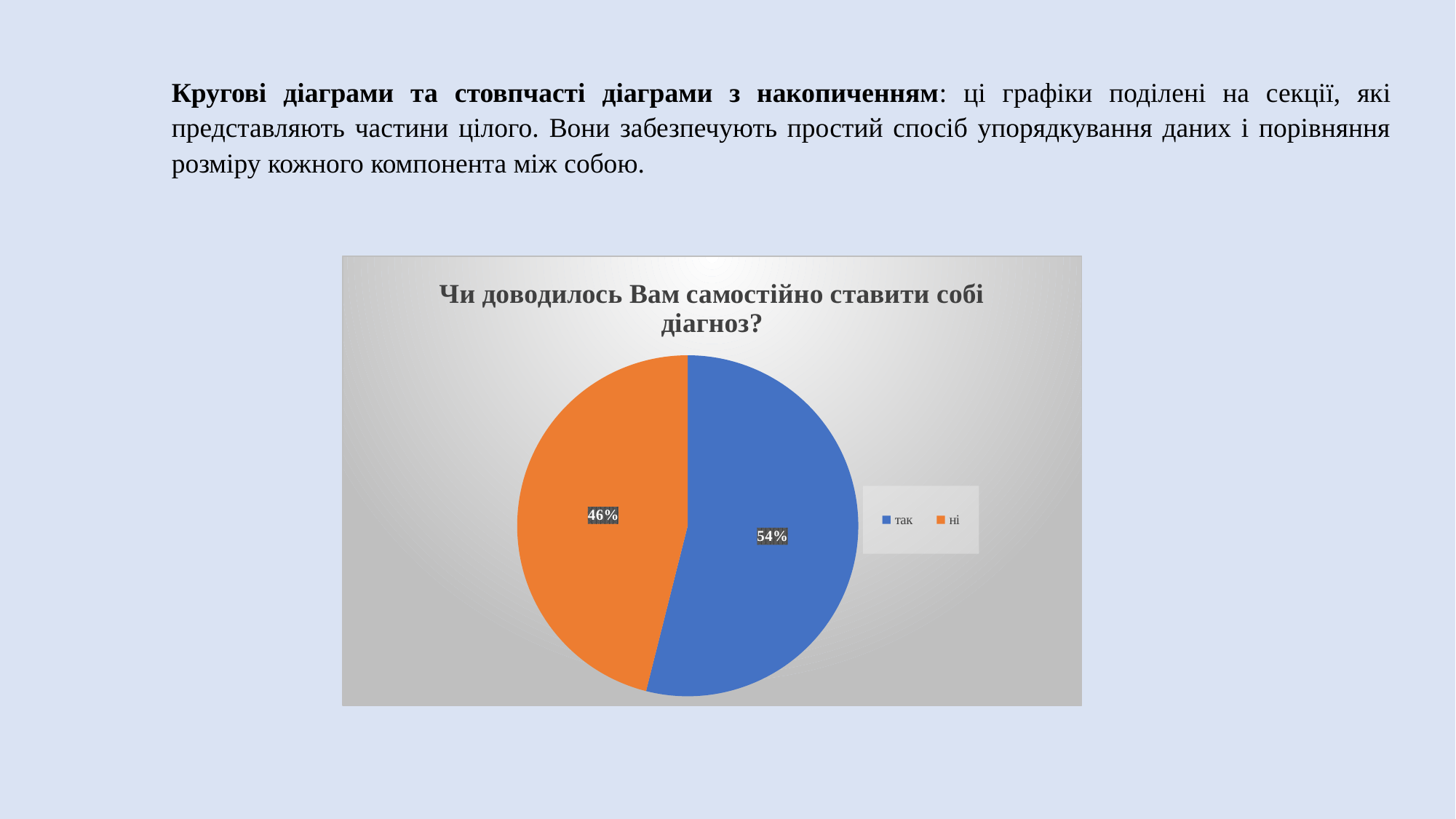
Which slice is the smallest? ні How many slices does the pie chart have? 2 What share of the pie is labelled "так"? 54% By how many percentage points does "так" exceed "ні"? 8% How many entries does the legend list? 2 What share of the pie is labelled "ні"? 46% What kind of chart is shown on the slide? pie chart What is the title of the chart? Чи доводилось Вам самостійно ставити собі діагноз? Is the share for "так" greater or less than 50%? greater What colour is the "ні" slice? orange Which is larger, the "так" slice or the "ні" slice? так Which slice is the largest? так